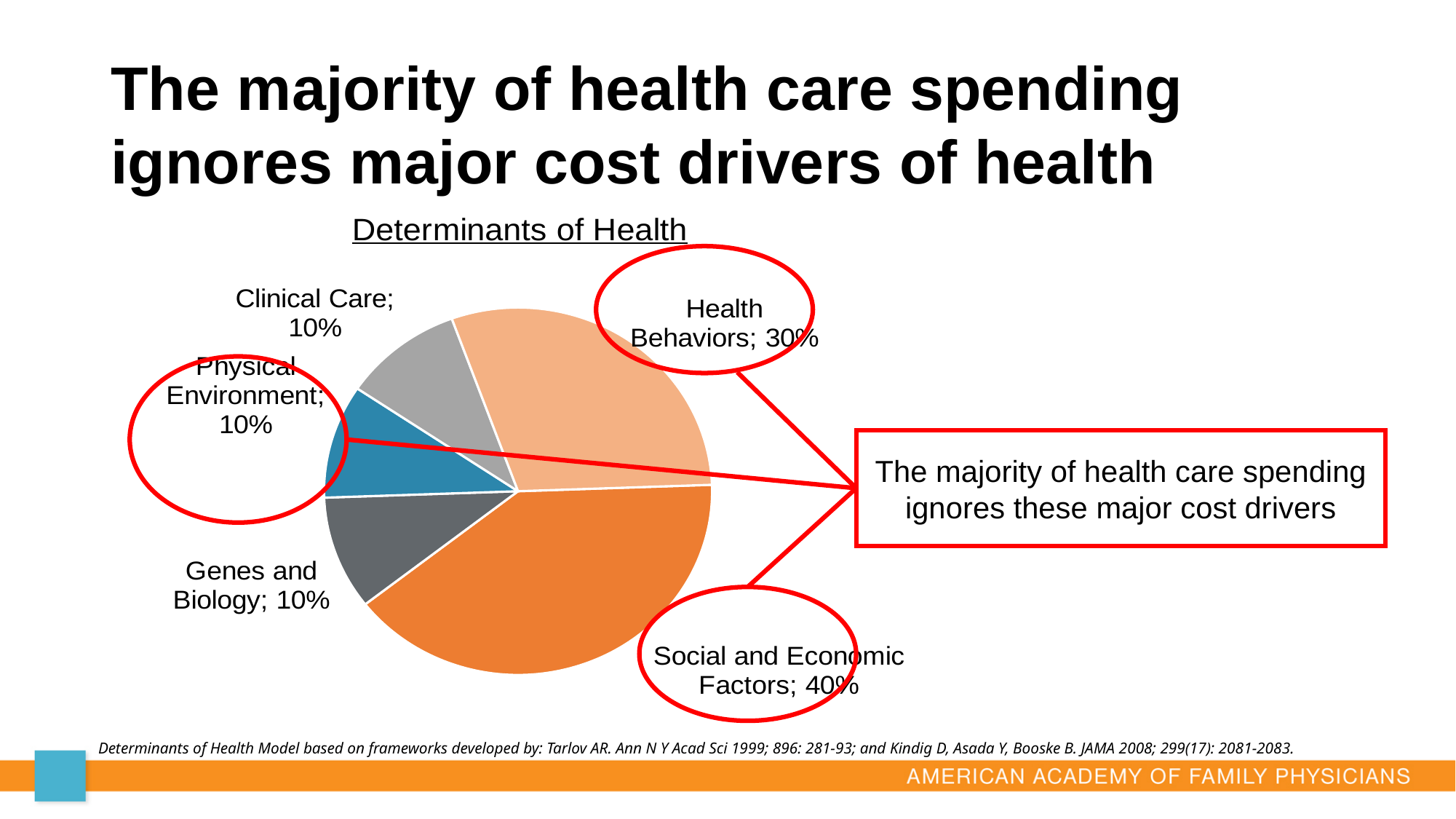
What is the difference in percentage points between Social and Economic Factors and Health Behaviors? 10 What percentage is shown for Genes and Biology? 10% Which slice of the pie is colored blue? Physical Environment What is the combined share of Health Behaviors and Social and Economic Factors? 70% What percentage is shown for Social and Economic Factors? 40% Which category has the largest slice of the pie? Social and Economic Factors What percentage is shown for Health Behaviors? 30% How many slices does the pie chart have? 5 What percentage is shown for Clinical Care? 10% Which is larger, Health Behaviors or Physical Environment? Health Behaviors What kind of chart is shown on the slide? pie chart What is the title of the chart? Determinants of Health